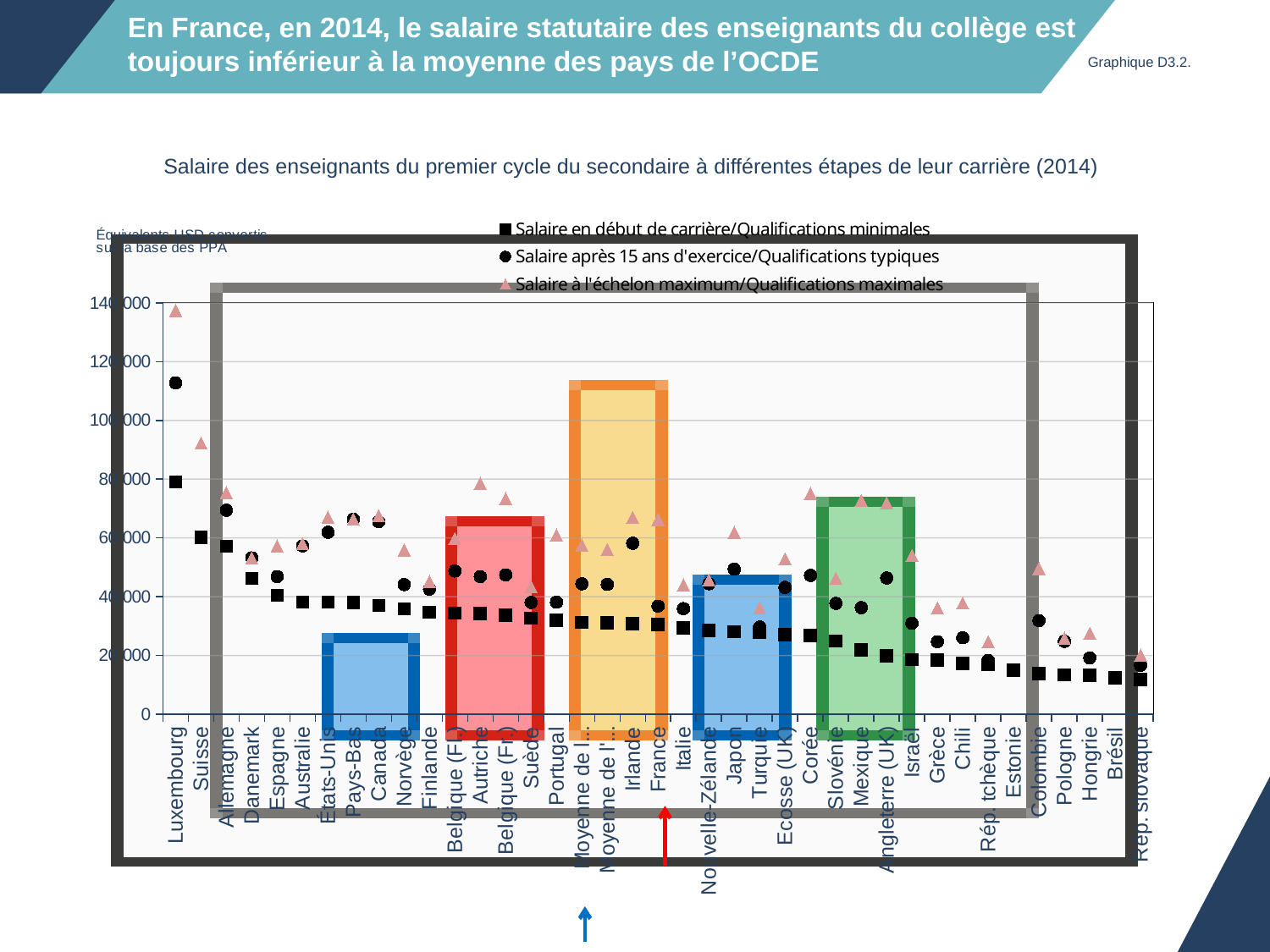
Is the value for France in the series 'Salaire en début de carrière/Qualifications minimales' greater or less than 40000? less Is the value for France in the series 'Salaire à l'échelon maximum/Qualifications maximales' greater or less than 60000? greater Which country has the lowest value for 'Salaire en début de carrière/Qualifications minimales'? Rép. slovaque Which has the larger value for 'Salaire en début de carrière/Qualifications minimales', Allemagne or France? Allemagne Do the values for 'Salaire en début de carrière/Qualifications minimales' generally rise or fall from left to right along the x axis? fall Is the value for Luxembourg in the series 'Salaire après 15 ans d'exercice/Qualifications typiques' greater or less than 100000? greater What is the title of the chart? Salaire des enseignants du premier cycle du secondaire à différentes étapes de leur carrière (2014) Which country has the highest value for 'Salaire à l'échelon maximum/Qualifications maximales'? Luxembourg Which country has the highest value for 'Salaire en début de carrière/Qualifications minimales'? Luxembourg What kind of chart is shown on the slide? scatter chart How many series does the chart legend list? 3